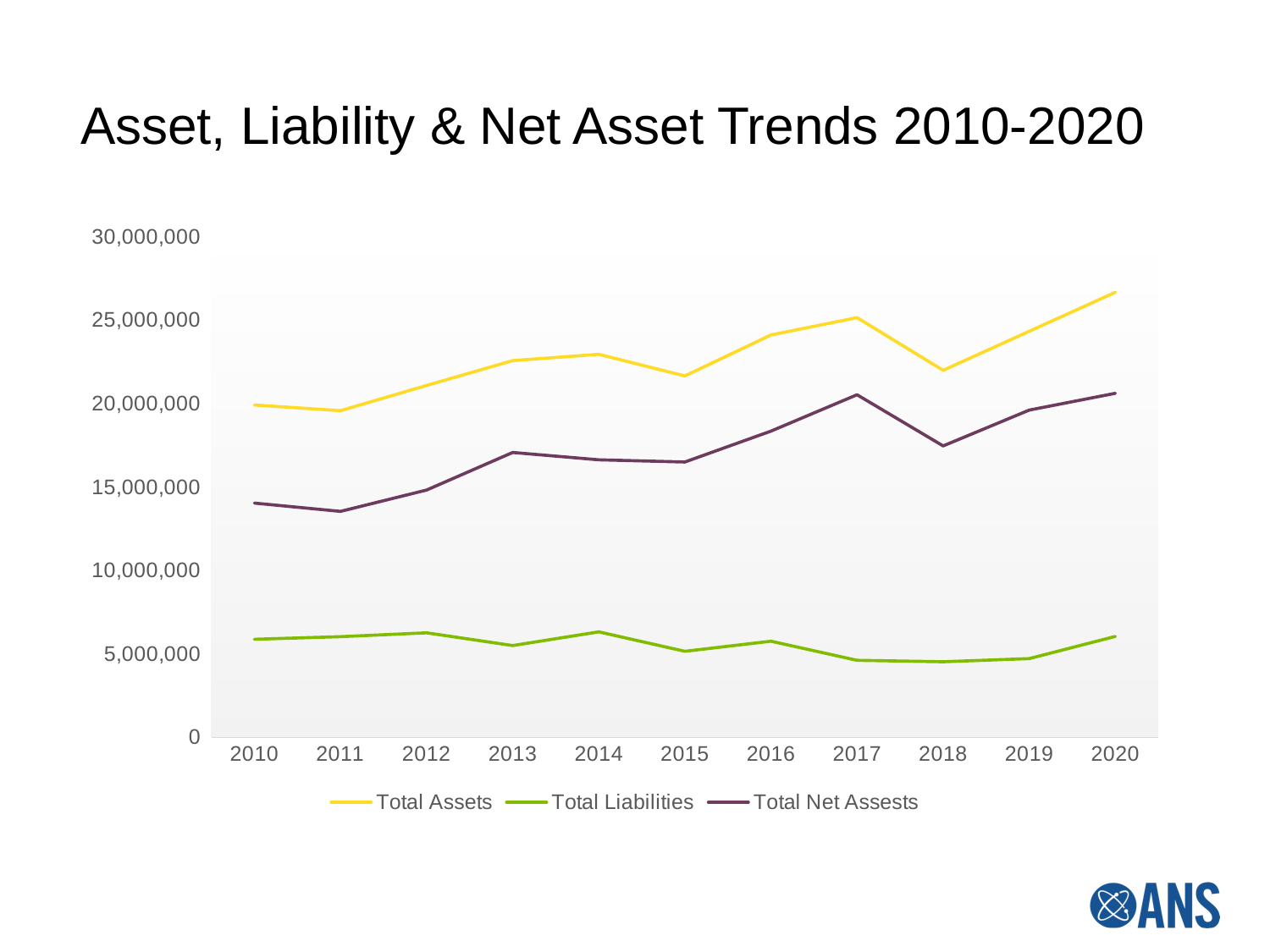
Is the value for Total Liabilities in 2017 greater or less than 5,000,000? less In which year is Total Assets highest? 2020 Which series is drawn in green? Total Liabilities How many series does the legend list? 3 What is the title of the chart? Asset, Liability & Net Asset Trends 2010-2020 Does Total Assets generally rise or fall from 2010 to 2020? Rise Is the value for Total Assets in 2016 greater or less than 25,000,000? less How many years are plotted along the x axis? 11 Is the value for Total Net Assests in 2010 greater or less than 15,000,000? less Which is larger for Total Net Assests: the value in 2017 or the value in 2018? 2017 What kind of chart is shown on the slide? Line chart